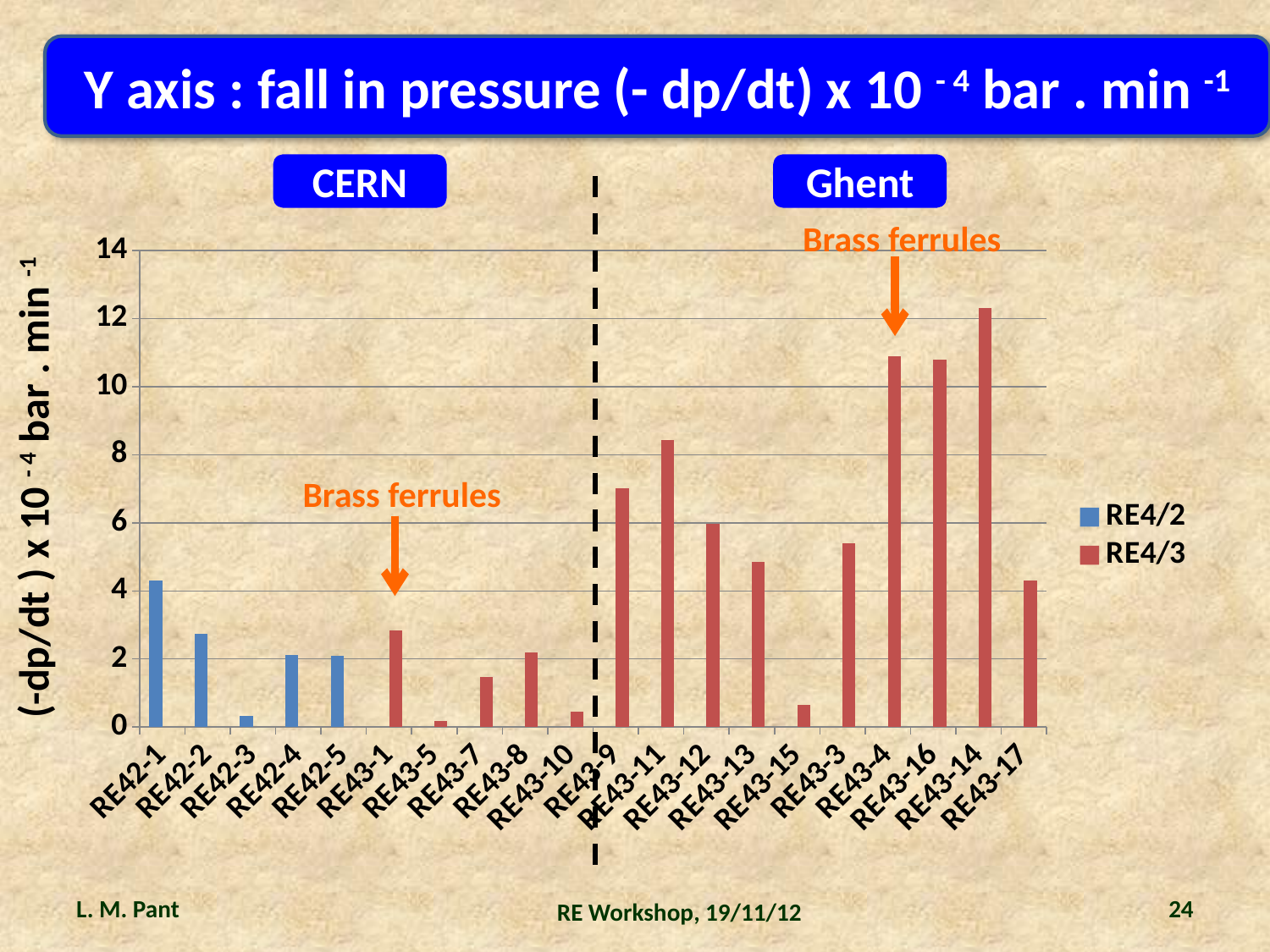
What are the two site labels shown above the chart? CERN and Ghent Is the value for RE43-14 greater or less than 10? greater Which category has the highest value? RE43-14 How many categories are plotted along the x axis? 20 Which is larger, the value for RE43-11 or the value for RE43-9? RE43-11 How many series does the legend list? 2 Is the value for RE42-3 greater or less than 2? less Is the value for RE43-9 greater or less than 6? greater Which is larger, the value for RE42-1 or the value for RE42-2? RE42-1 What kind of chart is shown on the slide? bar chart Which series is shown in blue according to the legend? RE4/2